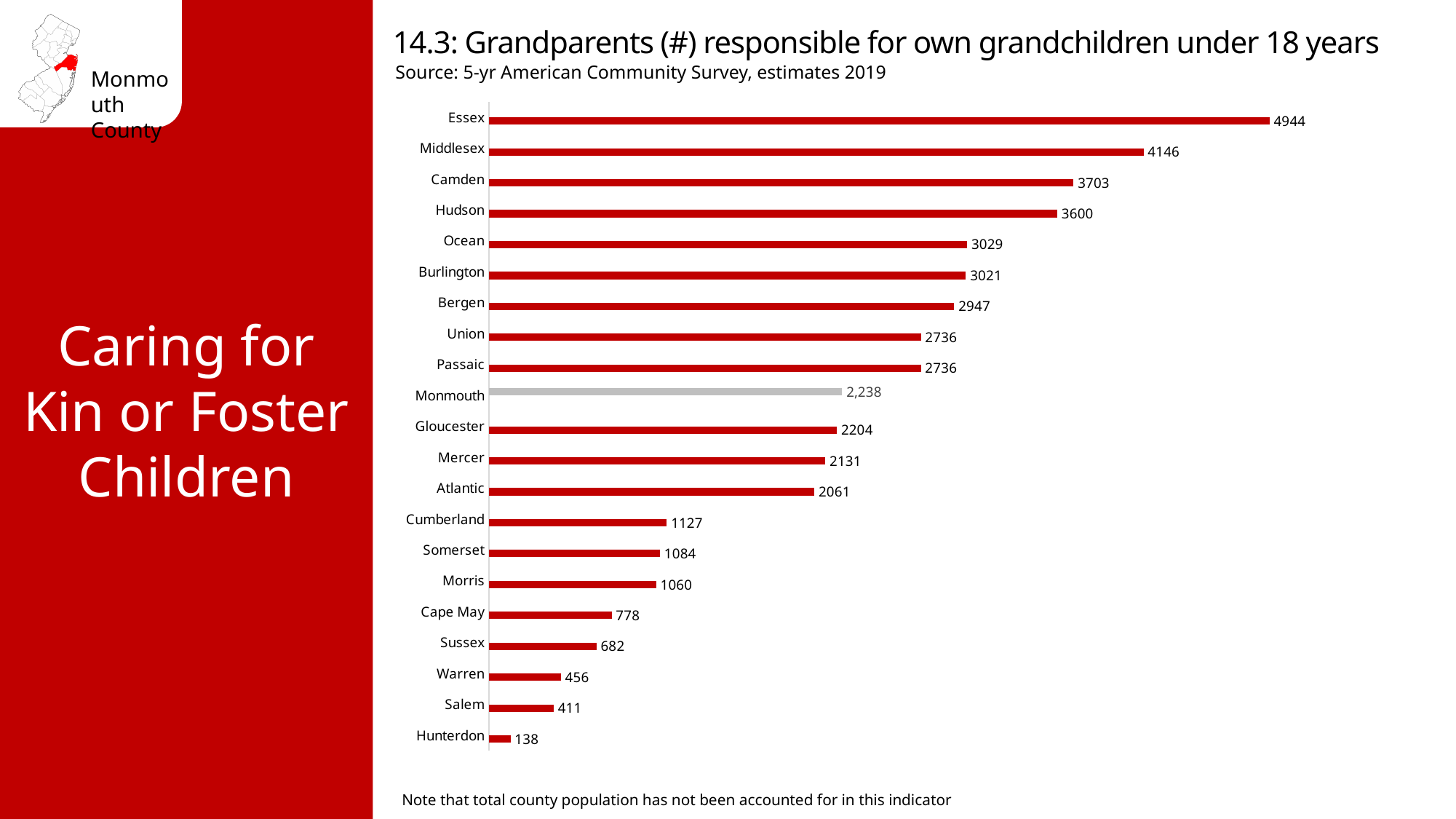
Which county has the lowest value? Hunterdon What is the value for Hunterdon? 138 How many counties are shown in the chart? 21 Which county has the highest value? Essex What kind of chart is shown on the slide? Bar chart What is the difference between the values for Monmouth and Gloucester? 34 What is the difference between the values for Essex and Middlesex? 798 What is the value for Monmouth? 2,238 Which bar is coloured grey instead of red? Monmouth What is the value for Gloucester? 2204 Which is larger, the value for Camden or the value for Ocean? Camden What is the value for Essex? 4944